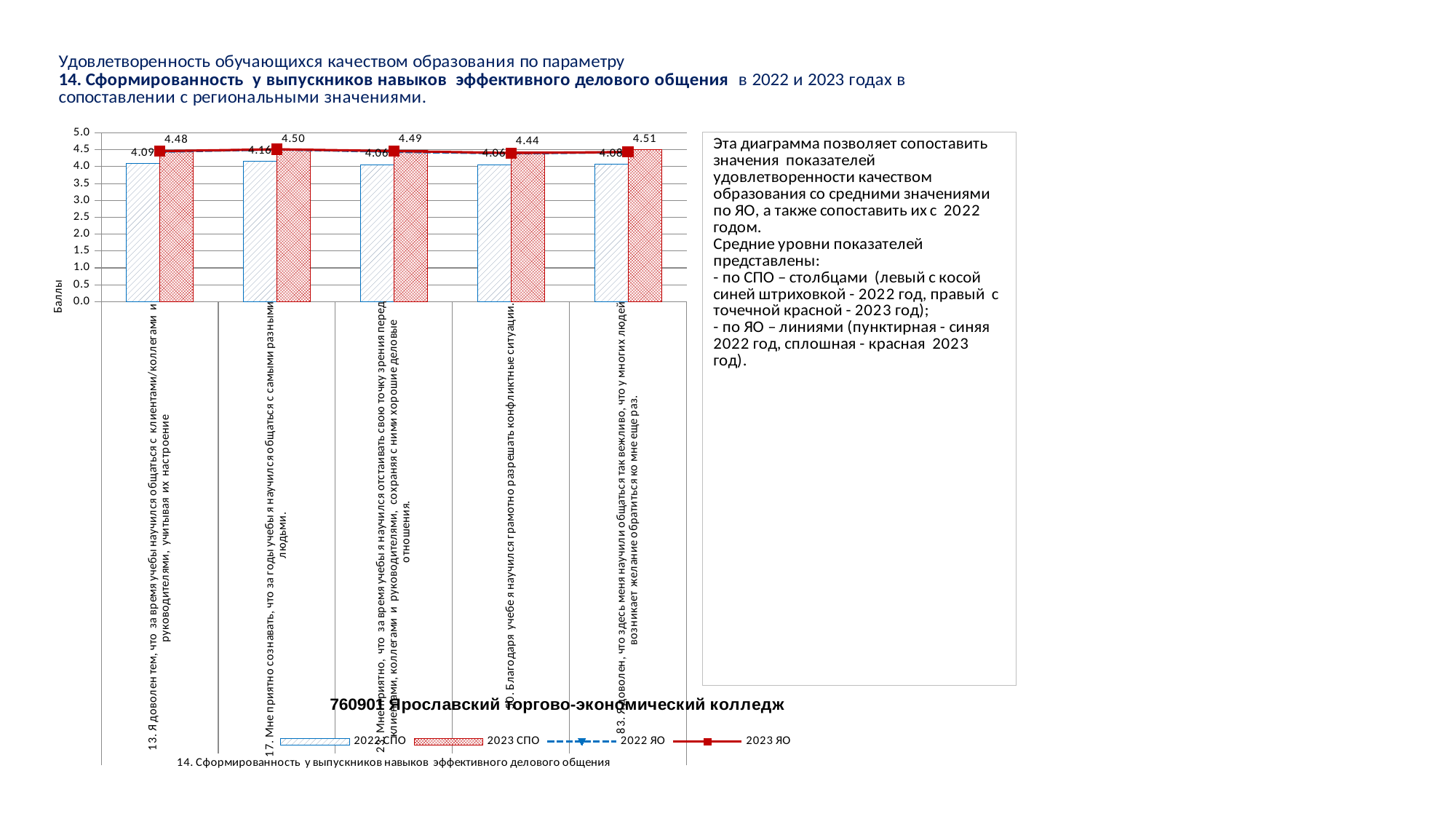
What is the difference between the 2023 СПО and 2022 СПО values for the last category (83)? 0.43 Is the 2022 СПО value for category 13 greater or less than 4.0? greater What is the 2022 СПО value for the category "17. Мне приятно сознавать, что за годы учебы я научился общаться с самыми разными людьми"? 4.16 Which category has the highest 2022 СПО value? 17. Мне приятно сознавать, что за годы учебы я научился общаться с самыми разными людьми (4.16) Which category has the lowest 2023 СПО value? Благодаря учебе я научился грамотно разрешать конфликтные ситуации (4.44) Which is larger: the 2022 СПО value for category 13 or for category 17? Category 17 (4.16) What is the 2023 СПО value for the last category, "83. Я доволен, что здесь меня научили общаться так вежливо..."? 4.51 How many series does the chart legend list? 4 What is the difference between the 2023 СПО and 2022 СПО values for the first category (13)? 0.39 How many categories are shown on the x axis of the chart? 5 What is the label of the vertical axis of the chart? Баллы What is the 2023 СПО value for the category "13. Я доволен тем, что за время учебы научился общаться с клиентами/коллегами и руководителями, учитывая их настроение"? 4.48